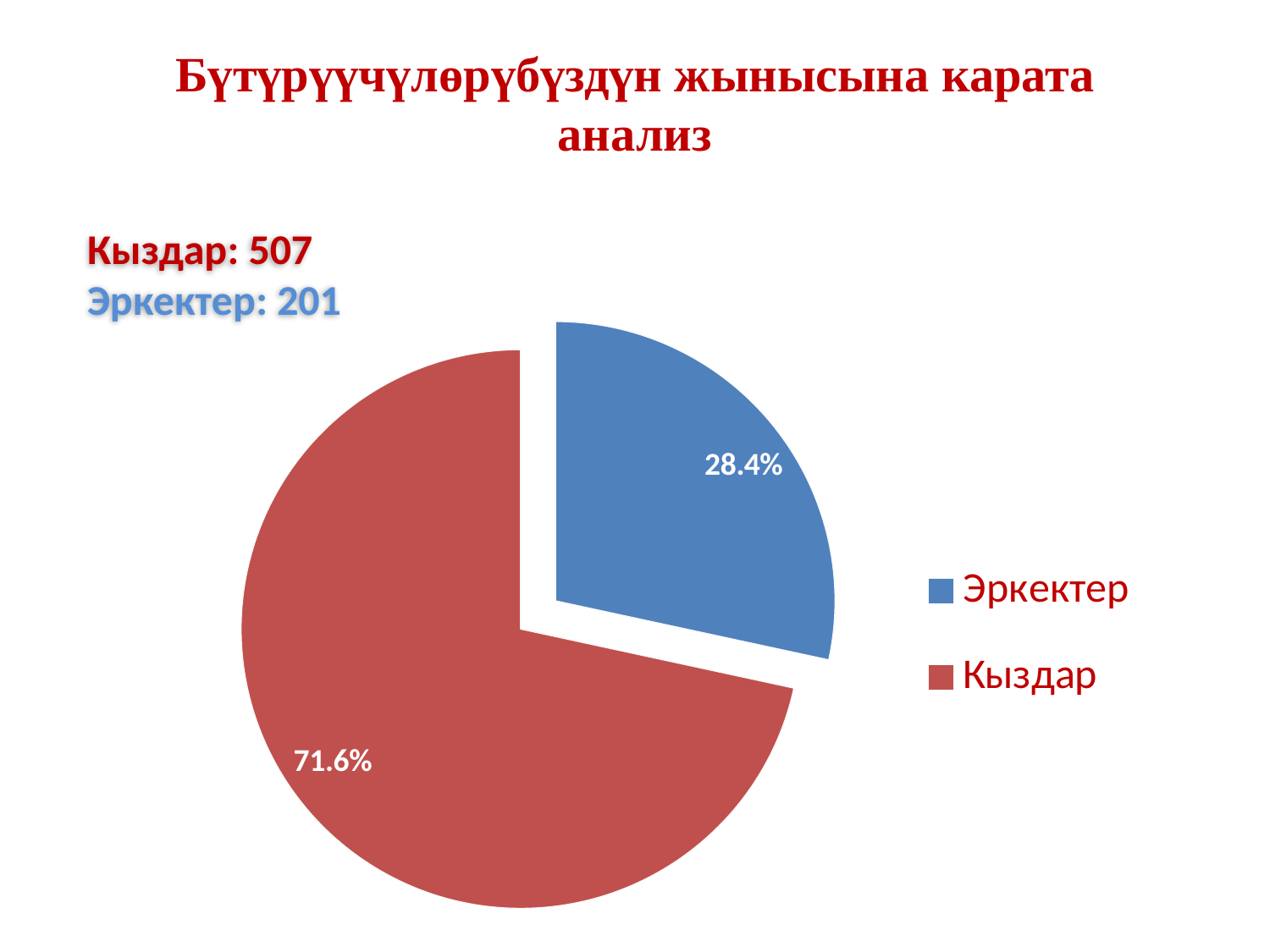
Which category has the largest slice of the pie? Кыздар Which is larger, the slice for Кыздар or the slice for Эркектер? Кыздар What share of the pie does Эркектер take? 28.4% What share of the pie does Кыздар take? 71.6% What is the difference in percentage points between the Кыздар slice and the Эркектер slice? 43.2 Is the share for Эркектер greater or less than 50%? less How many slices does the pie chart have? 2 What kind of chart is shown on the slide? pie chart How many entries does the legend list? 2 What colour is the Эркектер slice? blue Which category has the smallest slice of the pie? Эркектер What colour is the Кыздар slice? red